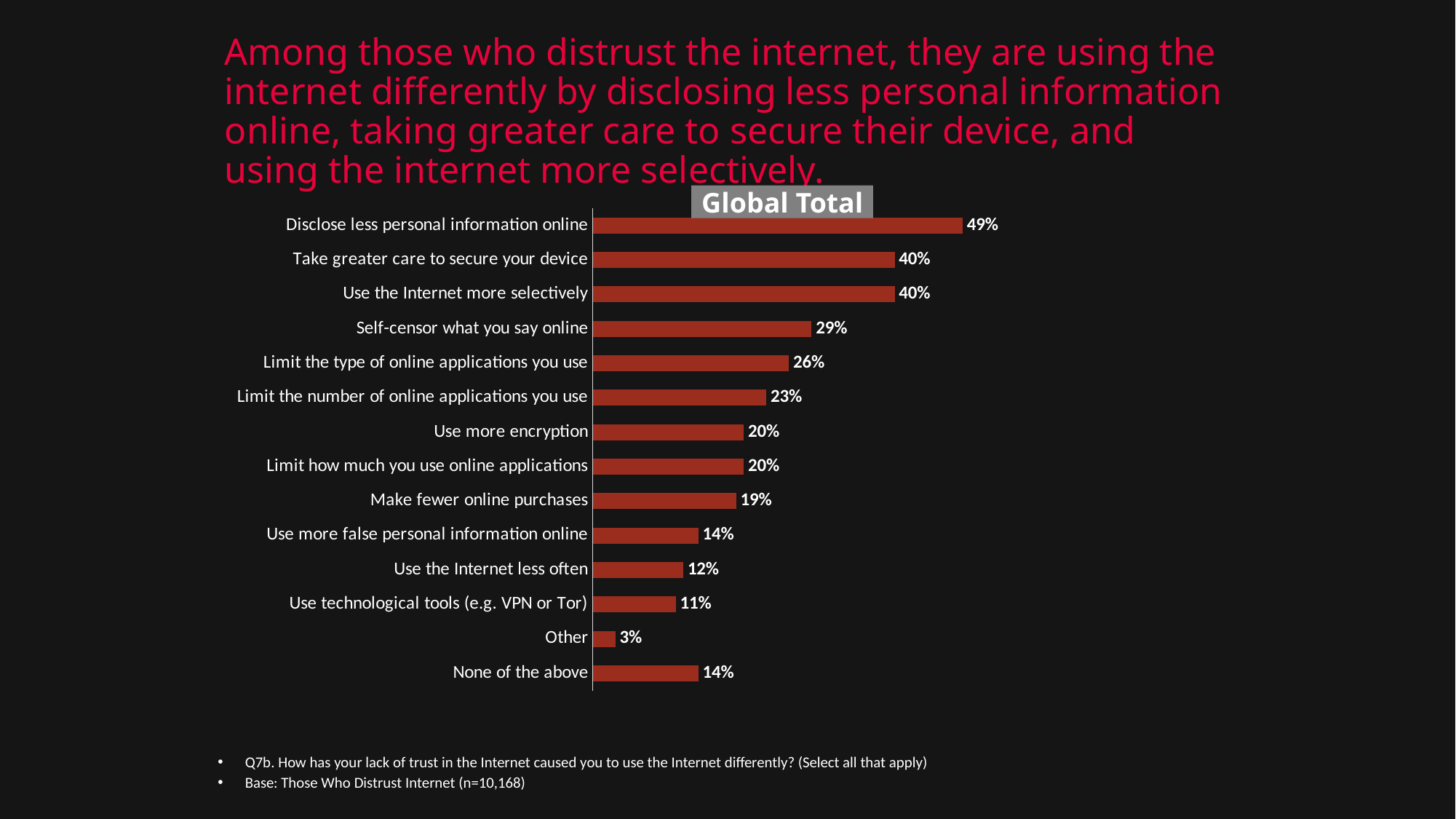
What is the value for "Use technological tools (e.g. VPN or Tor)"? 11% How many categories are shown in the chart? 14 What kind of chart is shown on the slide? Bar chart What is the value for "None of the above"? 14% Which category has the highest value? Disclose less personal information online Which is larger: "Make fewer online purchases" or "Use the Internet less often"? Make fewer online purchases What is the value for "Self-censor what you say online"? 29% Which category has the lowest value? Other What is the difference between "Limit the type of online applications you use" and "Limit the number of online applications you use"? 3% What is the title of the chart? Global Total What is the value for "Disclose less personal information online"? 49% What is the difference between "Disclose less personal information online" and "Take greater care to secure your device"? 9%